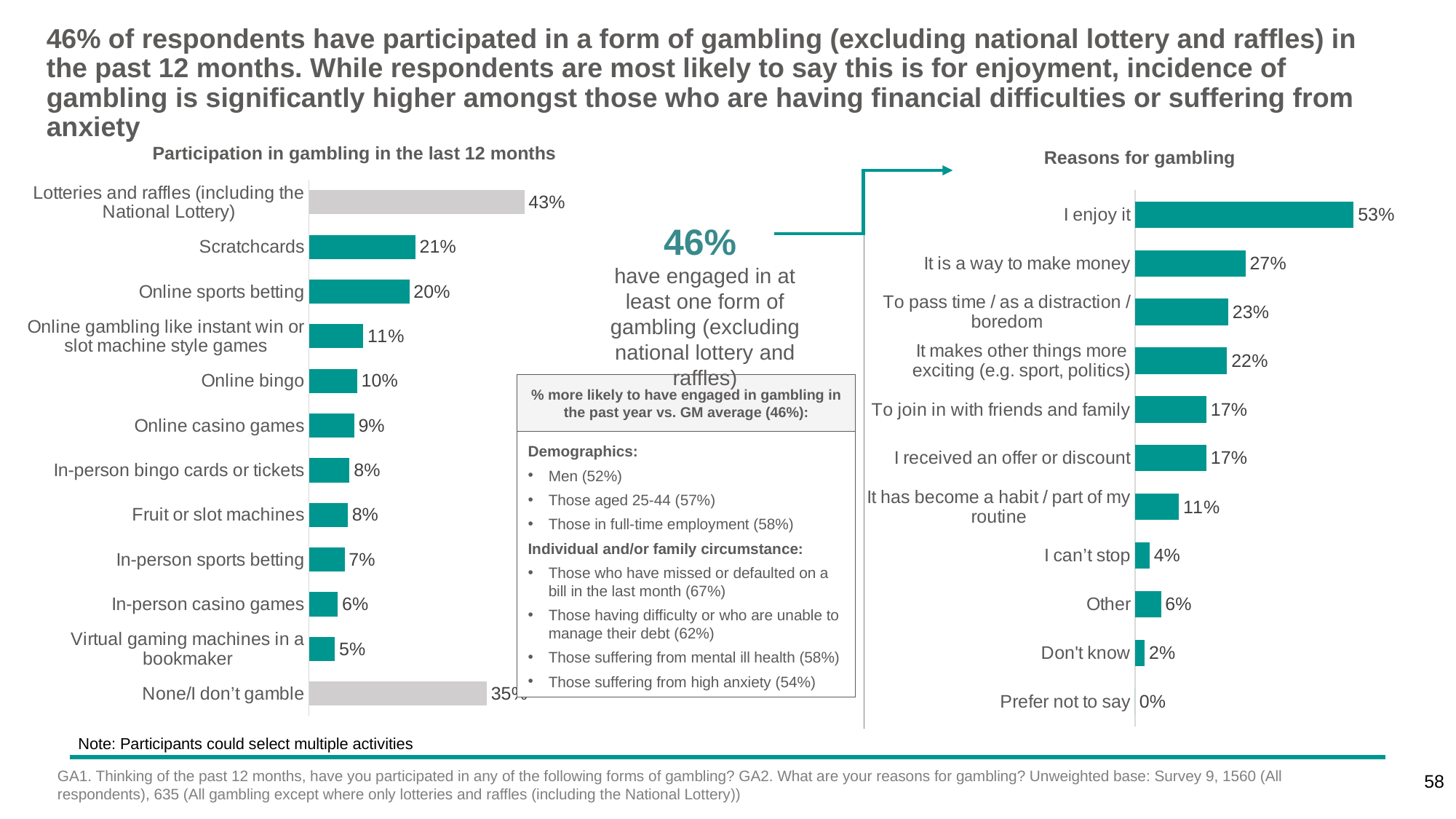
In the 'Reasons for gambling' chart, which reason has the lowest value? Prefer not to say In the 'Reasons for gambling' chart, which is larger: 'Other' or 'I can't stop'? Other How many reasons are listed in the 'Reasons for gambling' chart? 11 In the 'Participation in gambling in the last 12 months' chart, which category has the highest value? Lotteries and raffles (including the National Lottery) In the 'Reasons for gambling' chart, what percentage said 'I enjoy it'? 53% What type of chart is the 'Reasons for gambling' chart? Bar chart In the 'Reasons for gambling' chart, what is the value for 'It is a way to make money'? 27% In the 'Participation in gambling in the last 12 months' chart, which is larger: online casino games or in-person sports betting? Online casino games In the 'Participation in gambling in the last 12 months' chart, what is the difference between scratchcards and online bingo? 11 percentage points In the 'Participation in gambling in the last 12 months' chart, what is the value for online sports betting? 20% In the 'Reasons for gambling' chart, what is the difference between 'I enjoy it' and 'It is a way to make money'? 26 percentage points In the 'Participation in gambling in the last 12 months' chart, what percentage of respondents participated in scratchcards? 21%